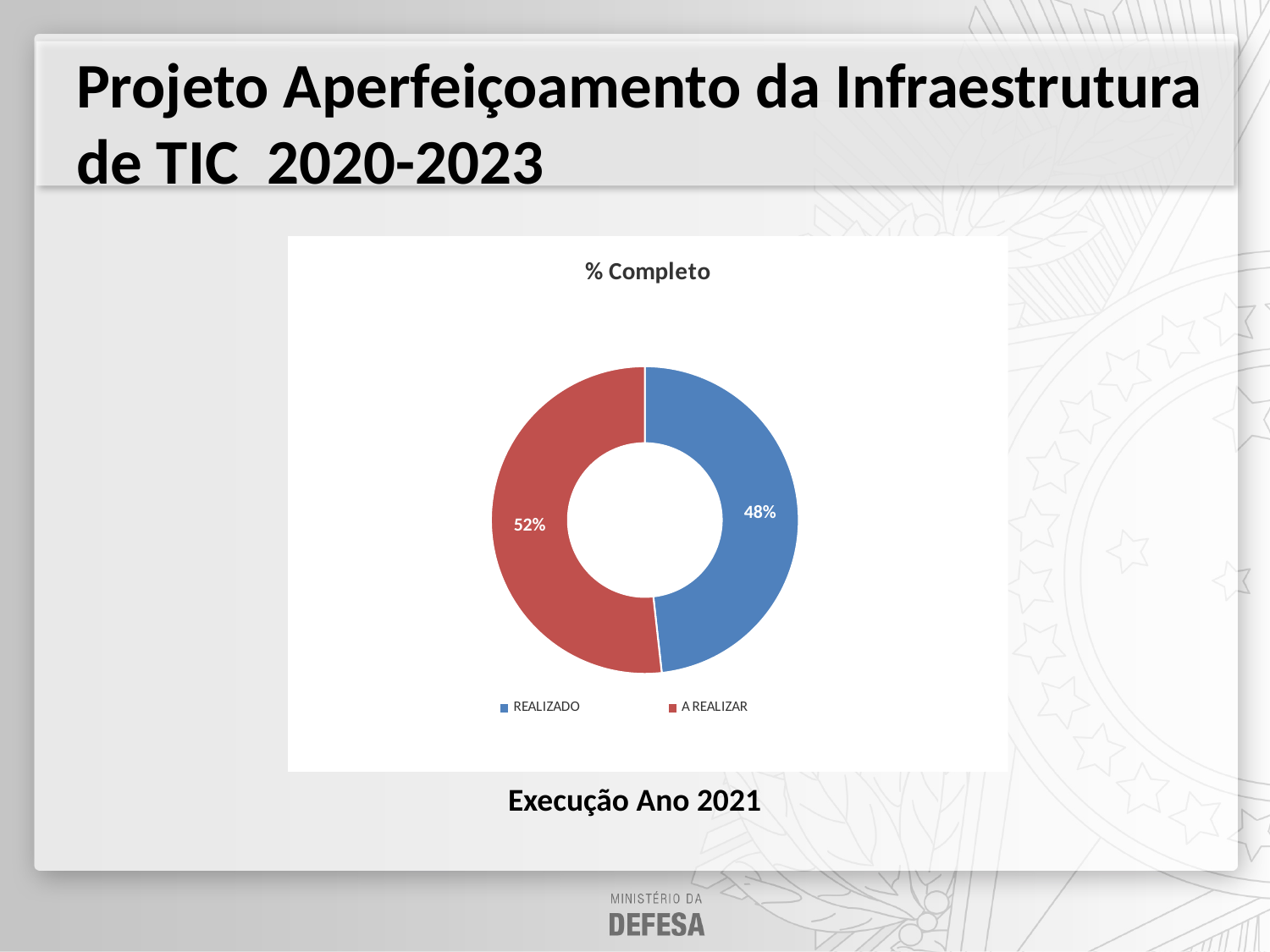
Which category has the larger share of the chart? A REALIZAR What kind of chart is shown on the slide? doughnut chart How many entries does the legend list? 2 How many categories does the chart show? 2 What is the title of the chart? % Completo Is the share for REALIZADO larger or smaller than the share for A REALIZAR? smaller Which colour represents A REALIZAR in the chart? red Which category has the smaller share of the chart? REALIZADO What percentage is shown for A REALIZAR? 52% What is the difference in percentage points between A REALIZAR and REALIZADO? 4 What percentage is shown for REALIZADO? 48% What is the total of the two percentages shown in the chart? 100%